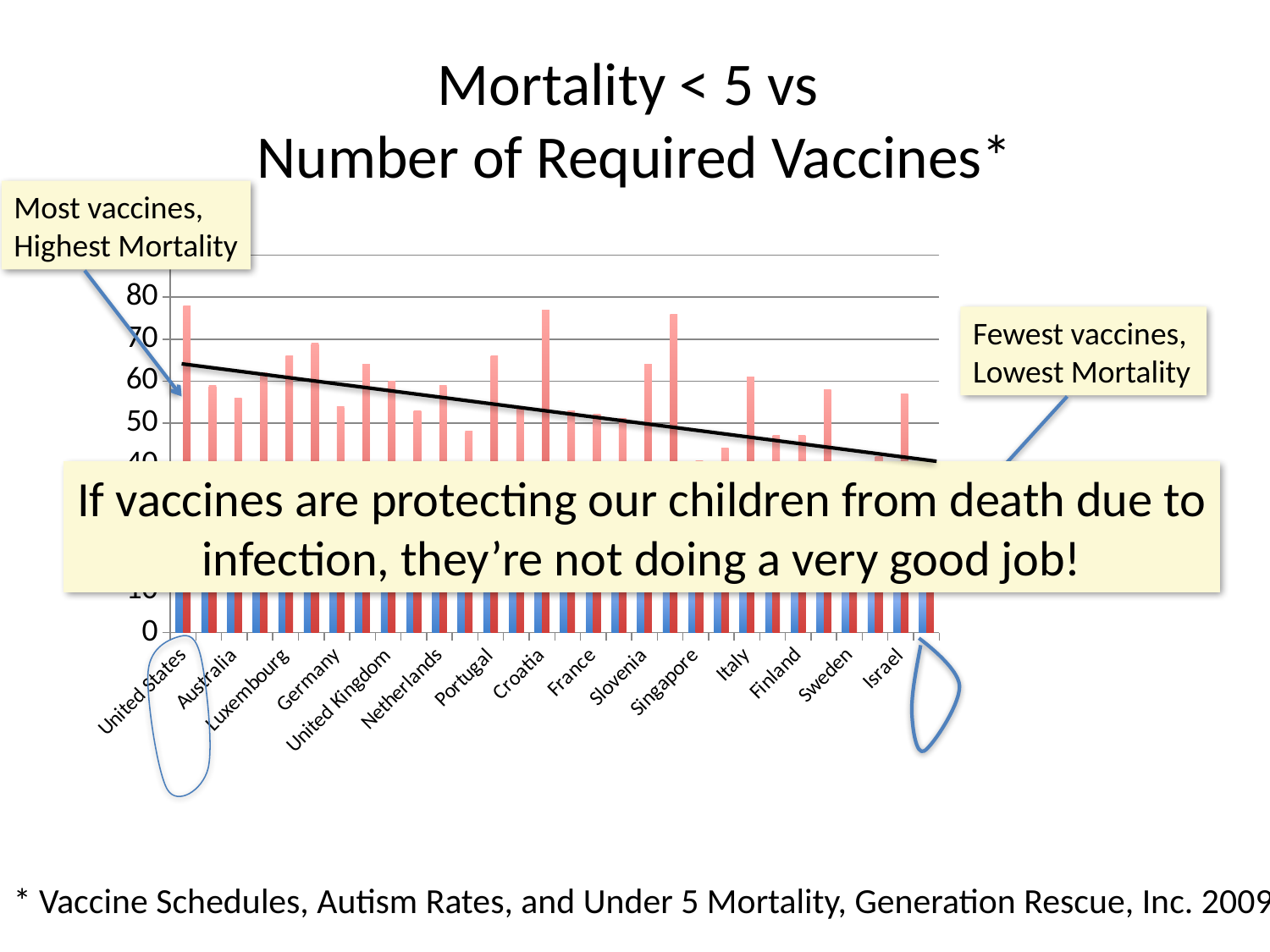
What kind of chart is shown on the slide? bar chart Which has the taller pink bar, United States or Australia? United States What is the title of the chart on the slide? Mortality < 5 vs Number of Required Vaccines* Is the value of the tall pink bar for United States greater or less than 70? greater What is the highest value shown on the vertical axis? 80 Which country is labelled first on the left of the x axis? United States Is the value of the tall pink bar for Croatia greater or less than 70? greater Is the value of the pink bar for Australia greater or less than 50? greater According to the drawn trend line, do the pink bar values generally rise or fall from left to right across the countries? fall